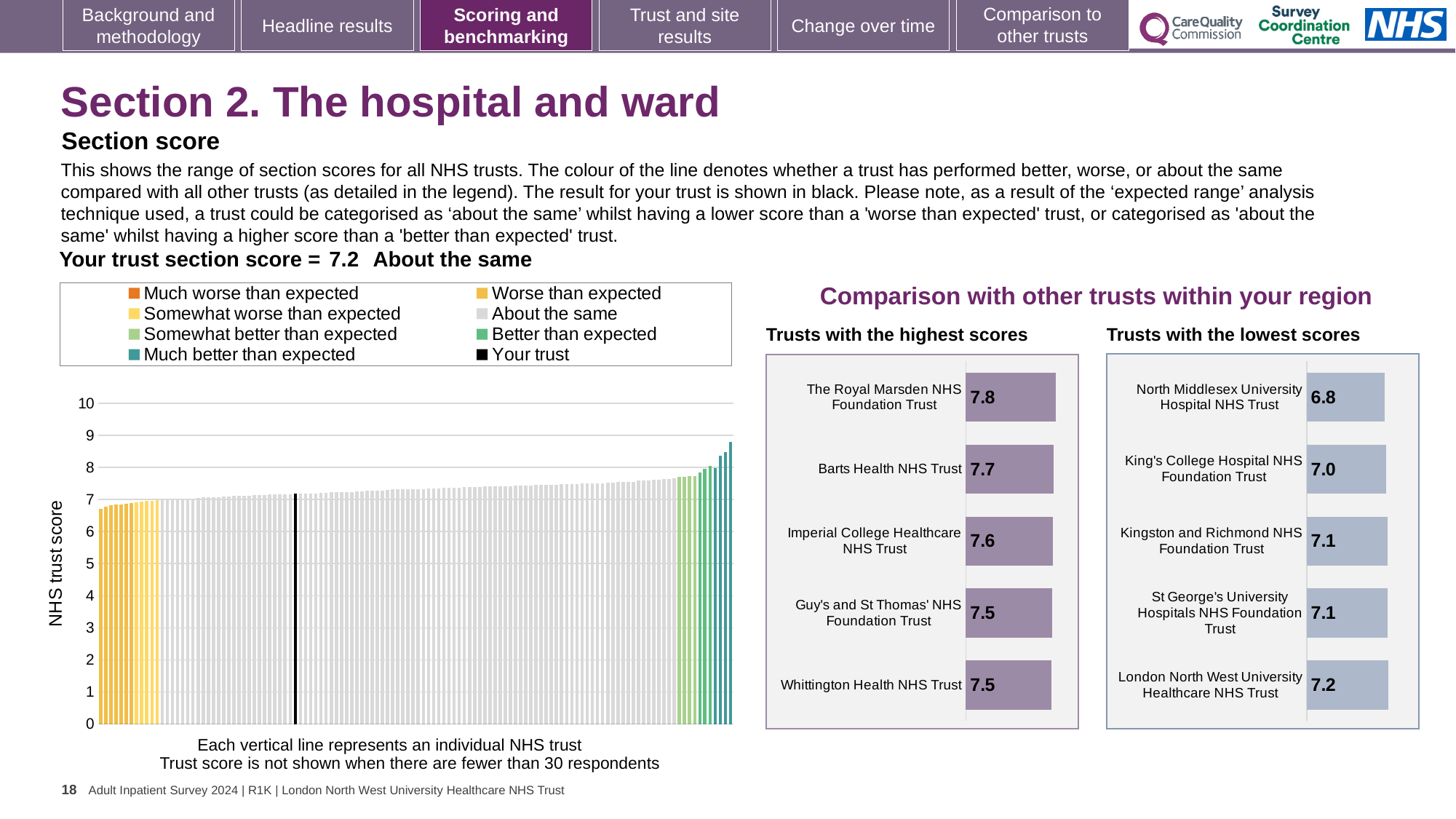
In the large 'NHS trust score' chart, is the value of the rightmost (highest) bar greater or less than 8? greater In the 'Trusts with the highest scores' chart, which trust has the highest score? The Royal Marsden NHS Foundation Trust In the 'Trusts with the highest scores' chart, what is the score for The Royal Marsden NHS Foundation Trust? 7.8 How many trusts are shown in the 'Trusts with the highest scores' chart? 5 In the 'Trusts with the highest scores' chart, what is the difference between the scores of The Royal Marsden NHS Foundation Trust and Whittington Health NHS Trust? 0.3 In the 'Trusts with the lowest scores' chart, which trust has the lowest score? North Middlesex University Hospital NHS Trust How many entries does the legend of the large 'NHS trust score' chart list? 8 In the 'Trusts with the highest scores' chart, which has the higher score: Barts Health NHS Trust or Imperial College Healthcare NHS Trust? Barts Health NHS Trust In the 'Trusts with the lowest scores' chart, what is the score for King's College Hospital NHS Foundation Trust? 7.0 What kind of chart is the large 'NHS trust score' chart on the left of the slide? Bar chart In the 'Trusts with the lowest scores' chart, what is the difference between the scores of London North West University Healthcare NHS Trust and North Middlesex University Hospital NHS Trust? 0.4 In the 'Trusts with the lowest scores' chart, what is the score for North Middlesex University Hospital NHS Trust? 6.8